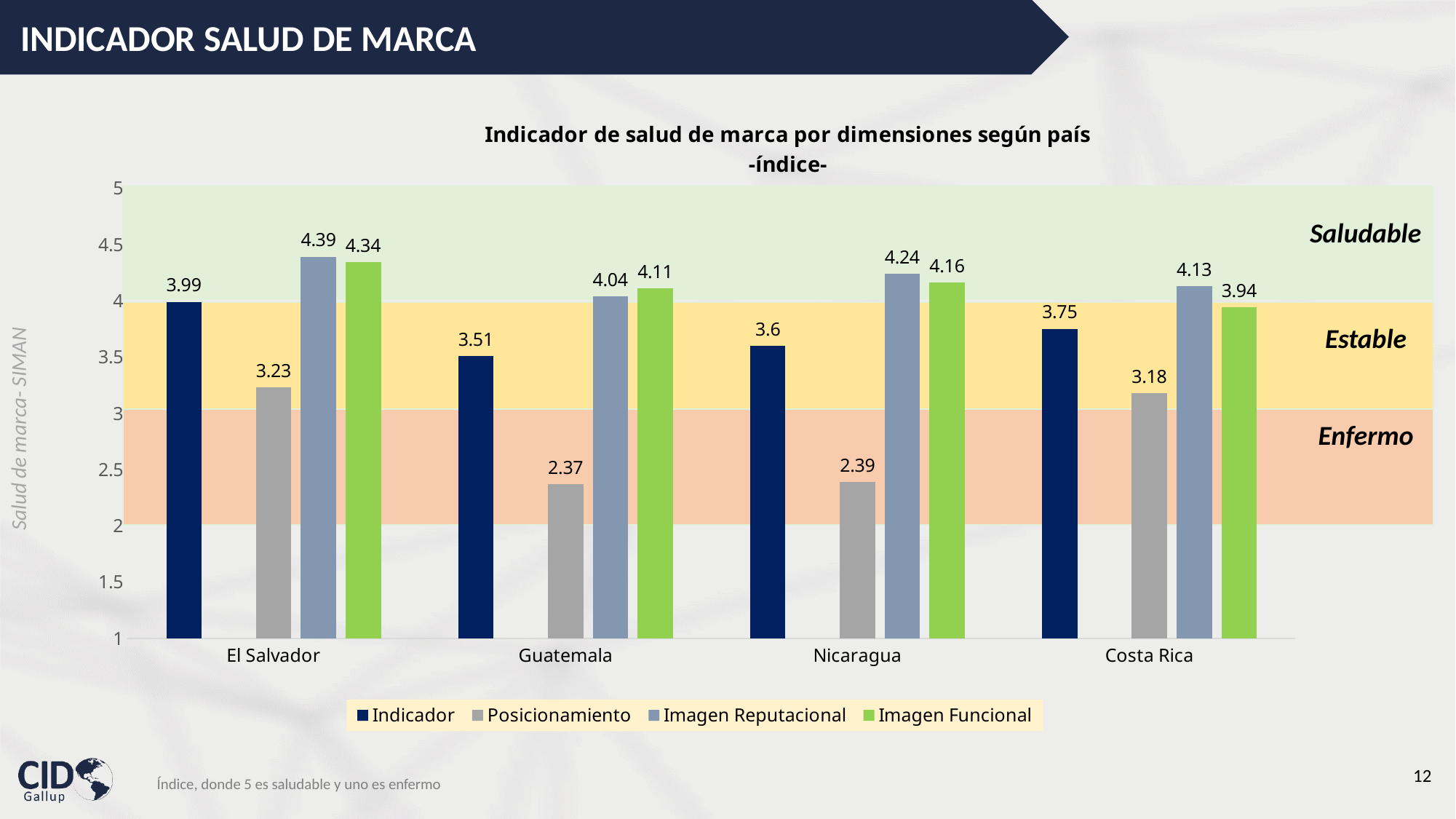
What is the Imagen Funcional value for Costa Rica? 3.94 What is the title of the chart? Indicador de salud de marca por dimensiones según país -índice- How many series does the legend list? 4 How many countries are shown on the x axis? 4 What is the difference between the Imagen Reputacional values for El Salvador and Costa Rica? 0.26 Which country has the lowest Posicionamiento value? Guatemala What is the Indicador value for El Salvador? 3.99 Which is larger, the Imagen Funcional value for Nicaragua or for Guatemala? Nicaragua Is the Posicionamiento value for Nicaragua greater or less than 3? less What kind of chart is shown on the slide? bar chart Which country has the highest Indicador value? El Salvador What is the Posicionamiento value for Guatemala? 2.37